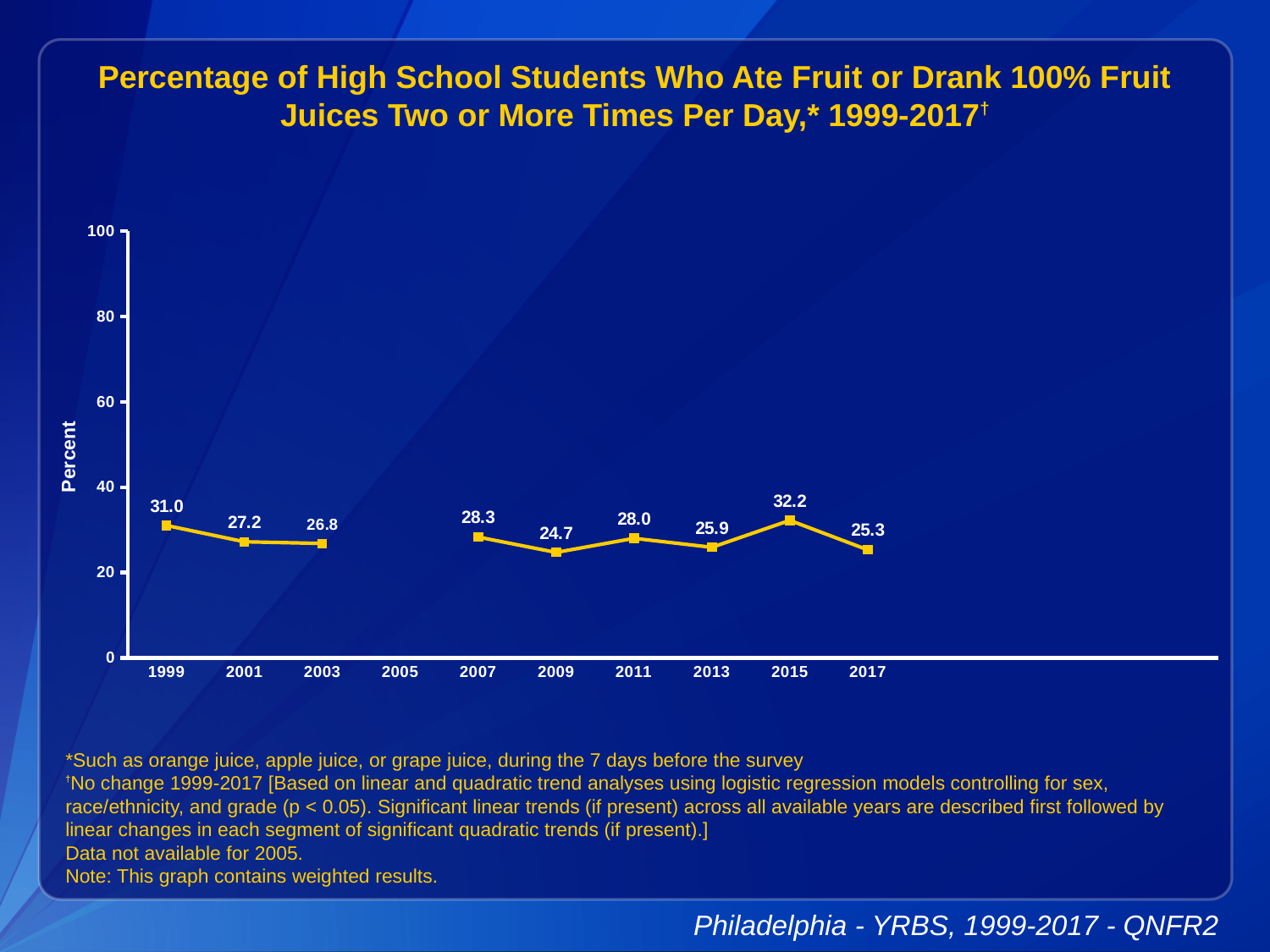
What value is plotted for 2017? 25.3 What is the difference between the values for 2015 and 2017? 6.9 What value is plotted for 2009? 24.7 Which is larger, the value for 2007 or the value for 2013? 2007 What value is plotted for 2015? 32.2 Which year has the lowest plotted value? 2009 What was the percentage of high school students who ate fruit or drank 100% fruit juices two or more times per day in 1999? 31.0 What kind of chart is shown on the slide? line chart Which year has the highest plotted value? 2015 Which year on the x axis has no data point plotted? 2005 Is the value for 2011 greater or less than 40? less How many years have data points plotted on the chart? 9